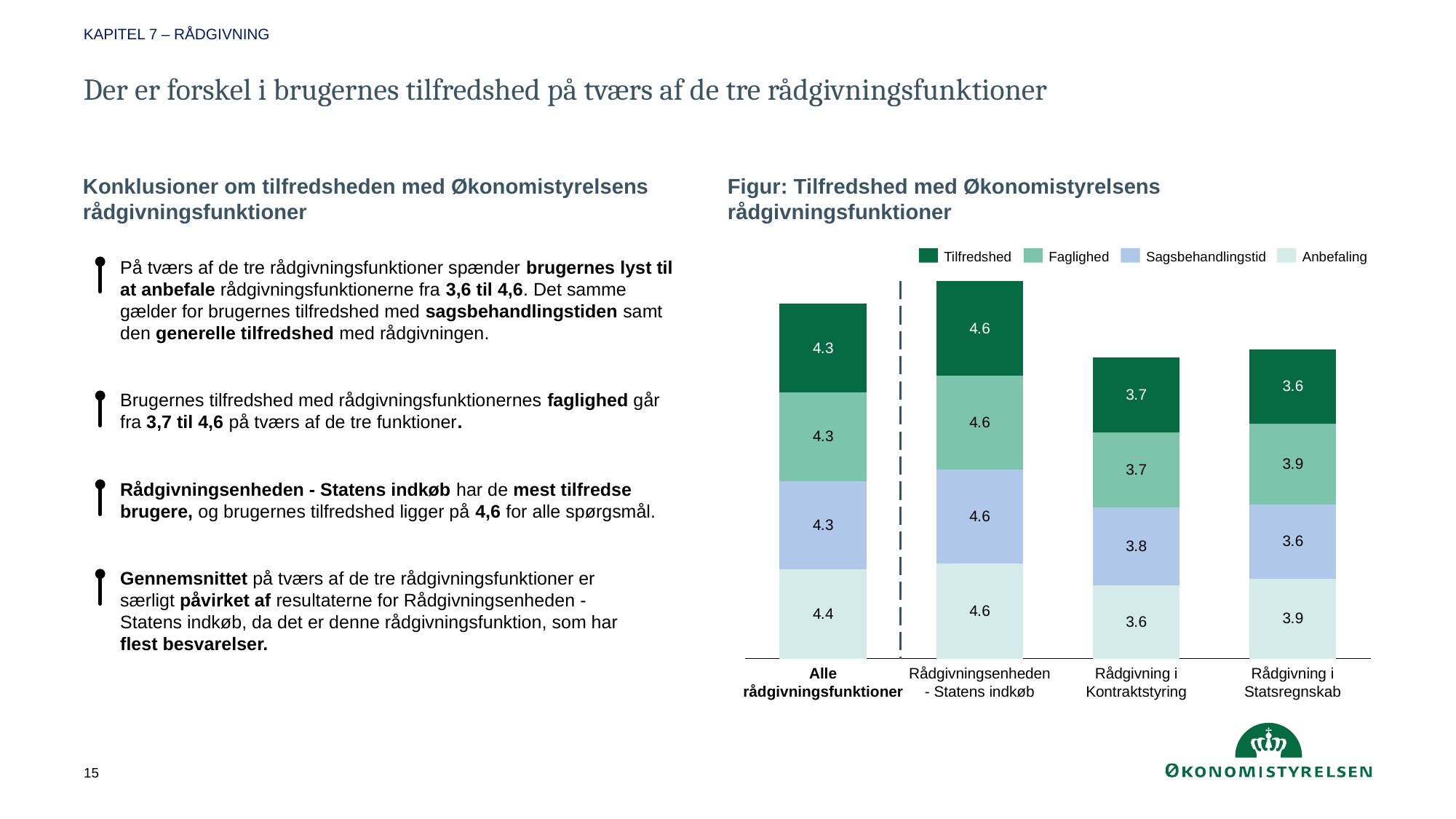
What is the Tilfredshed value for Rådgivningsenheden - Statens indkøb? 4.6 How many series does the legend list? 4 Which category has the lowest Anbefaling value? Rådgivning i Kontraktstyring Which category has the highest Tilfredshed value? Rådgivningsenheden - Statens indkøb What is the difference between the Tilfredshed values for Rådgivningsenheden - Statens indkøb and Rådgivning i Statsregnskab? 1.0 What is the Anbefaling value for Rådgivning i Kontraktstyring? 3.6 What is the total of the stacked bar for Rådgivning i Kontraktstyring? 14.8 What is the Faglighed value for Alle rådgivningsfunktioner? 4.3 How many categories are shown on the x axis? 4 Which is larger: the Faglighed value for Rådgivning i Statsregnskab or for Rådgivning i Kontraktstyring? Rådgivning i Statsregnskab What kind of chart is shown on the slide? Stacked bar chart What is the Sagsbehandlingstid value for Rådgivning i Statsregnskab? 3.6